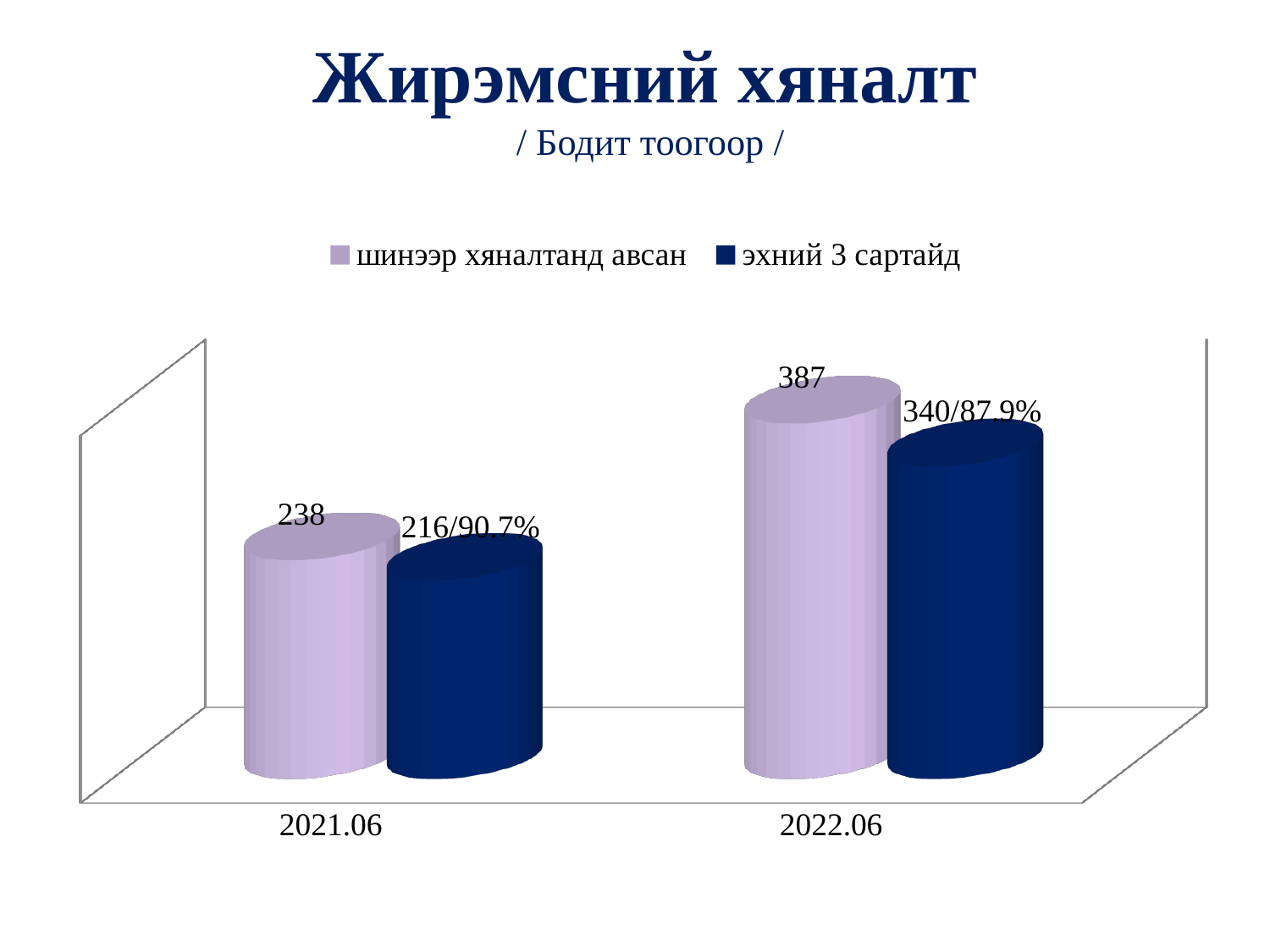
How many series does the legend list? 2 What kind of chart is shown on the slide? bar chart What is the value for 'шинээр хяналтанд авсан' in 2022.06? 387 What is the value for 'шинээр хяналтанд авсан' in 2021.06? 238 Which period has the higher value for 'шинээр хяналтанд авсан'? 2022.06 Which period has the lower value for 'эхний 3 сартайд'? 2021.06 What is the data label for 'эхний 3 сартайд' in 2022.06? 340/87.9% In 2022.06, which series has the larger value: 'шинээр хяналтанд авсан' or 'эхний 3 сартайд'? шинээр хяналтанд авсан What is the difference between the 'шинээр хяналтанд авсан' values for 2022.06 and 2021.06? 149 How many periods are shown on the x axis? 2 What is the data label for 'эхний 3 сартайд' in 2021.06? 216/90.7% Does the value for 'шинээр хяналтанд авсан' rise or fall from 2021.06 to 2022.06? rise